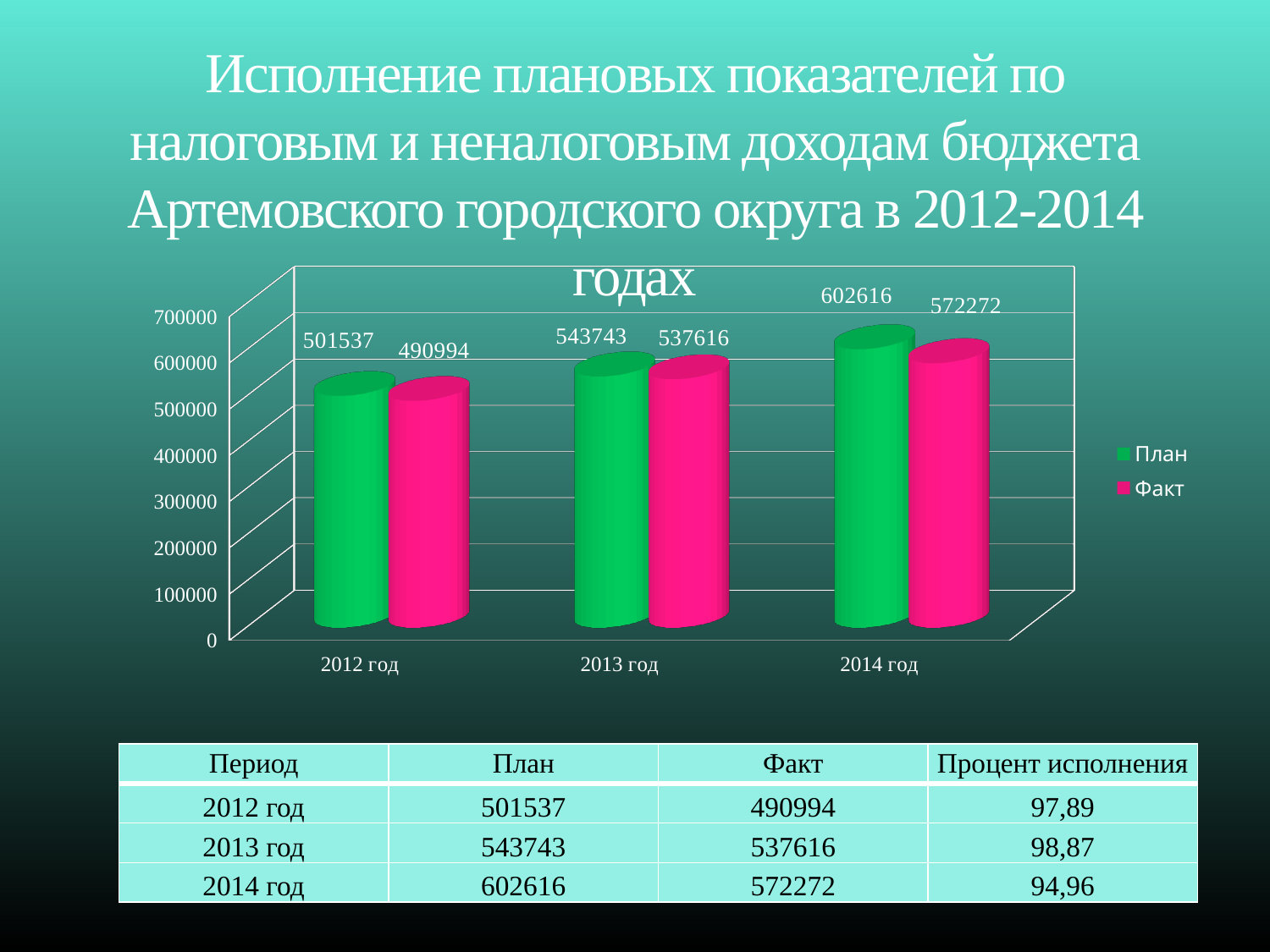
Which year has the lowest Факт value? 2012 год Which year has the highest План value? 2014 год What is the difference between План and Факт for 2012 год? 10543 How many years are shown on the x axis? 3 What kind of chart is shown on the slide? bar chart What is the Факт value for 2014 год? 572272 Do the Факт values rise or fall from 2012 год to 2014 год? rise What is the Факт value for 2013 год? 537616 What is the difference between План and Факт for 2014 год? 30344 Which is larger for 2013 год, План or Факт? План What is the План value for 2012 год? 501537 How many series does the legend list? 2